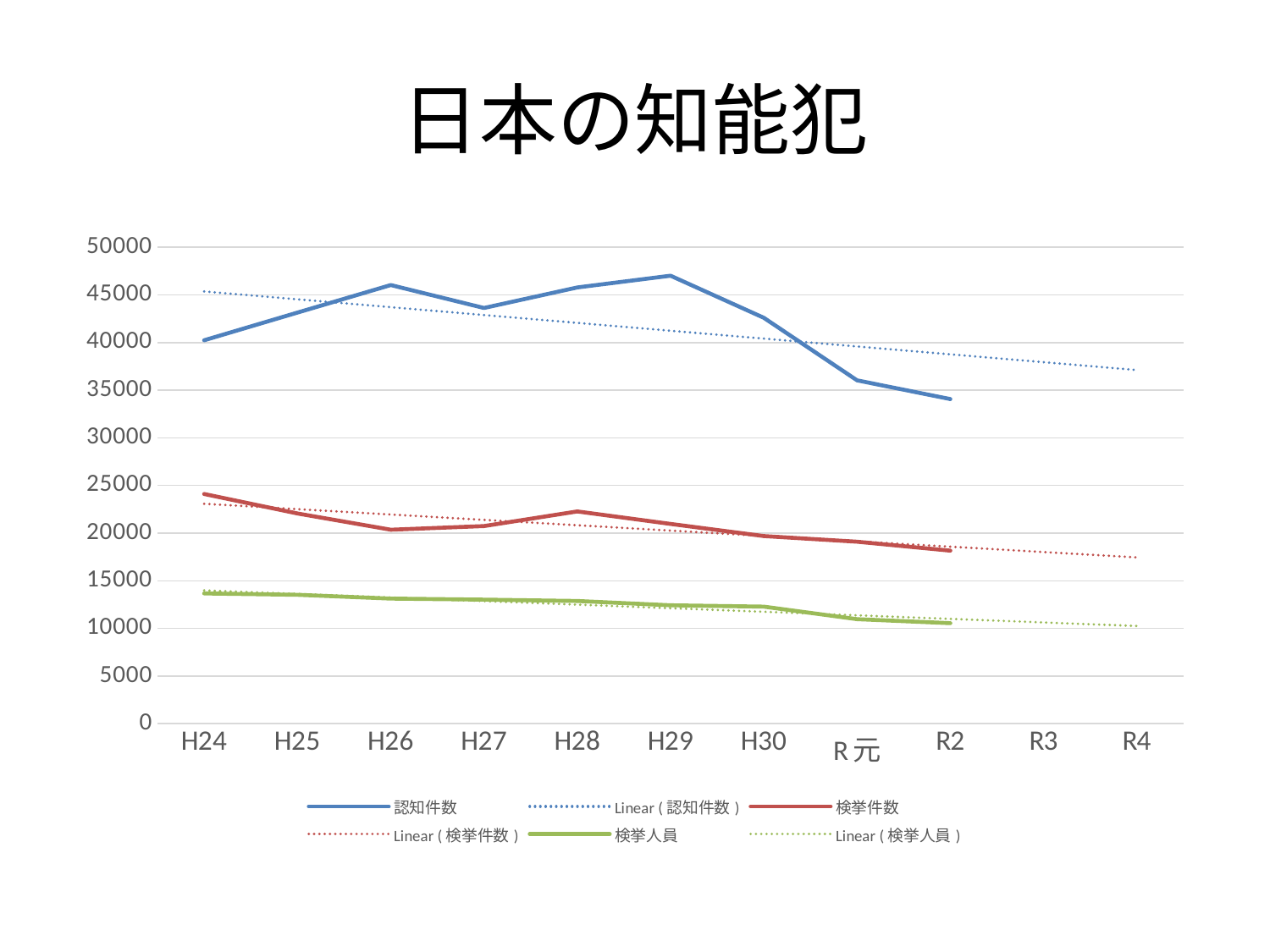
In which year is 認知件数 lowest? R2 How many year labels are shown on the x axis? 11 In which year is 検挙件数 highest? H24 In which year is 認知件数 highest? H29 Is the value for 認知件数 in H24 greater or less than 45000? less Does 検挙人員 rise or fall from H24 to R2? fall Which is larger in H28, 認知件数 or 検挙件数? 認知件数 What is the title of the chart? 日本の知能犯 What kind of chart is shown on the slide? line chart Is the value for 検挙件数 in H24 greater or less than 20000? greater How many entries does the legend list? 6 In which year is 検挙人員 lowest? R2